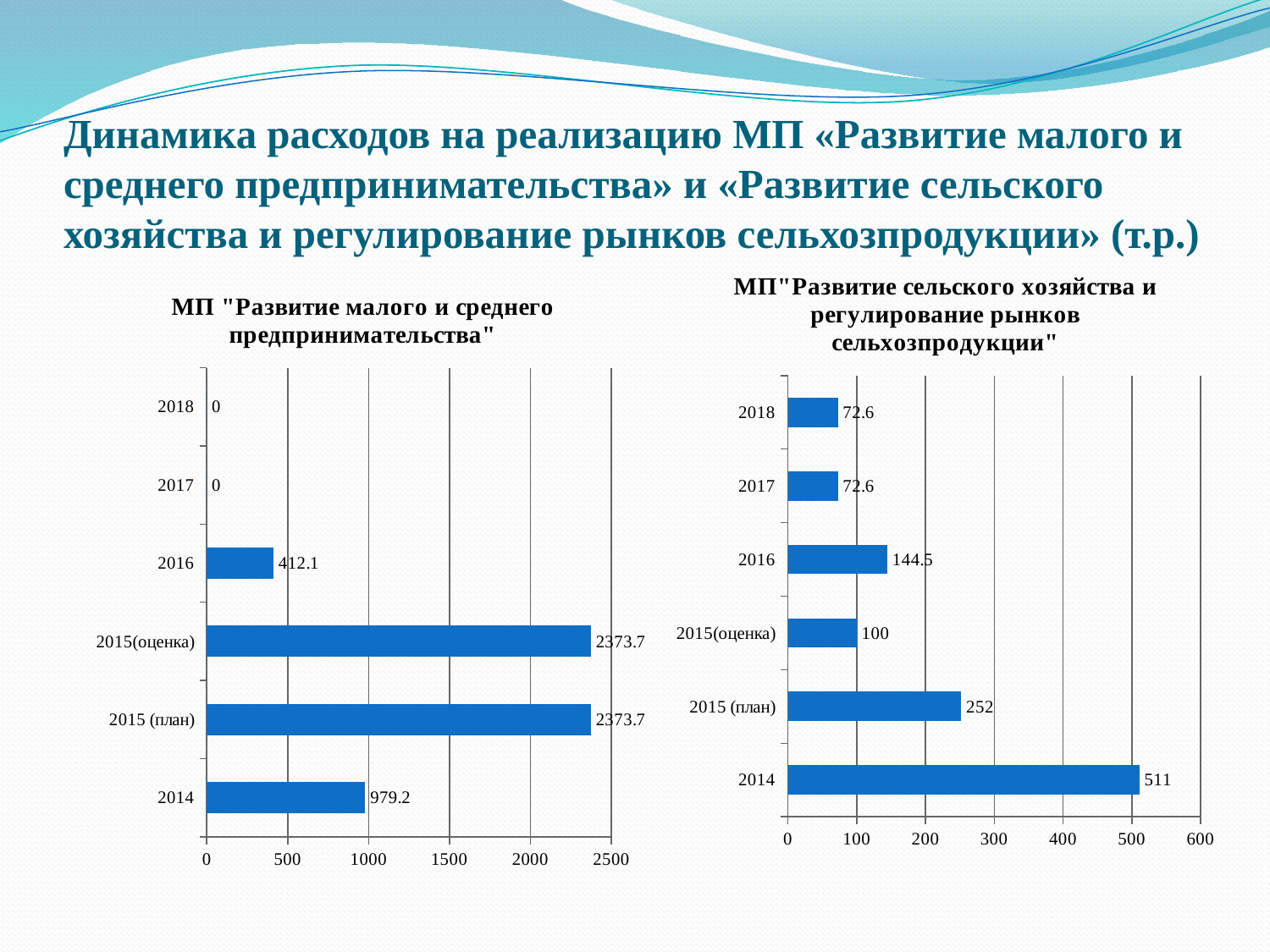
In the right chart (МП "Развитие сельского хозяйства и регулирование рынков сельхозпродукции"), what is the difference between the 2015 (план) value and the 2015(оценка) value? 152 In the left chart (МП "Развитие малого и среднего предпринимательства"), what is the value for 2016? 412.1 In the left chart (МП "Развитие малого и среднего предпринимательства"), how many categories are shown on the vertical axis? 6 In the right chart (МП "Развитие сельского хозяйства и регулирование рынков сельхозпродукции"), which category has the highest value? 2014 In the right chart (МП "Развитие сельского хозяйства и регулирование рынков сельхозпродукции"), which is larger, the value for 2016 or the value for 2017? 2016 In the right chart (МП "Развитие сельского хозяйства и регулирование рынков сельхозпродукции"), what is the value for 2014? 511 In the right chart (МП "Развитие сельского хозяйства и регулирование рынков сельхозпродукции"), what is the value for 2016? 144.5 In the left chart (МП "Развитие малого и среднего предпринимательства"), which category has the lowest non-zero value? 2016 In the left chart (МП "Развитие малого и среднего предпринимательства"), what is the value for 2015 (план)? 2373.7 What type of chart is the right chart (МП "Развитие сельского хозяйства и регулирование рынков сельхозпродукции")? Bar chart In the left chart (МП "Развитие малого и среднего предпринимательства"), what is the value for 2014? 979.2 In the left chart (МП "Развитие малого и среднего предпринимательства"), what is the difference between the 2015(оценка) value and the 2014 value? 1394.5